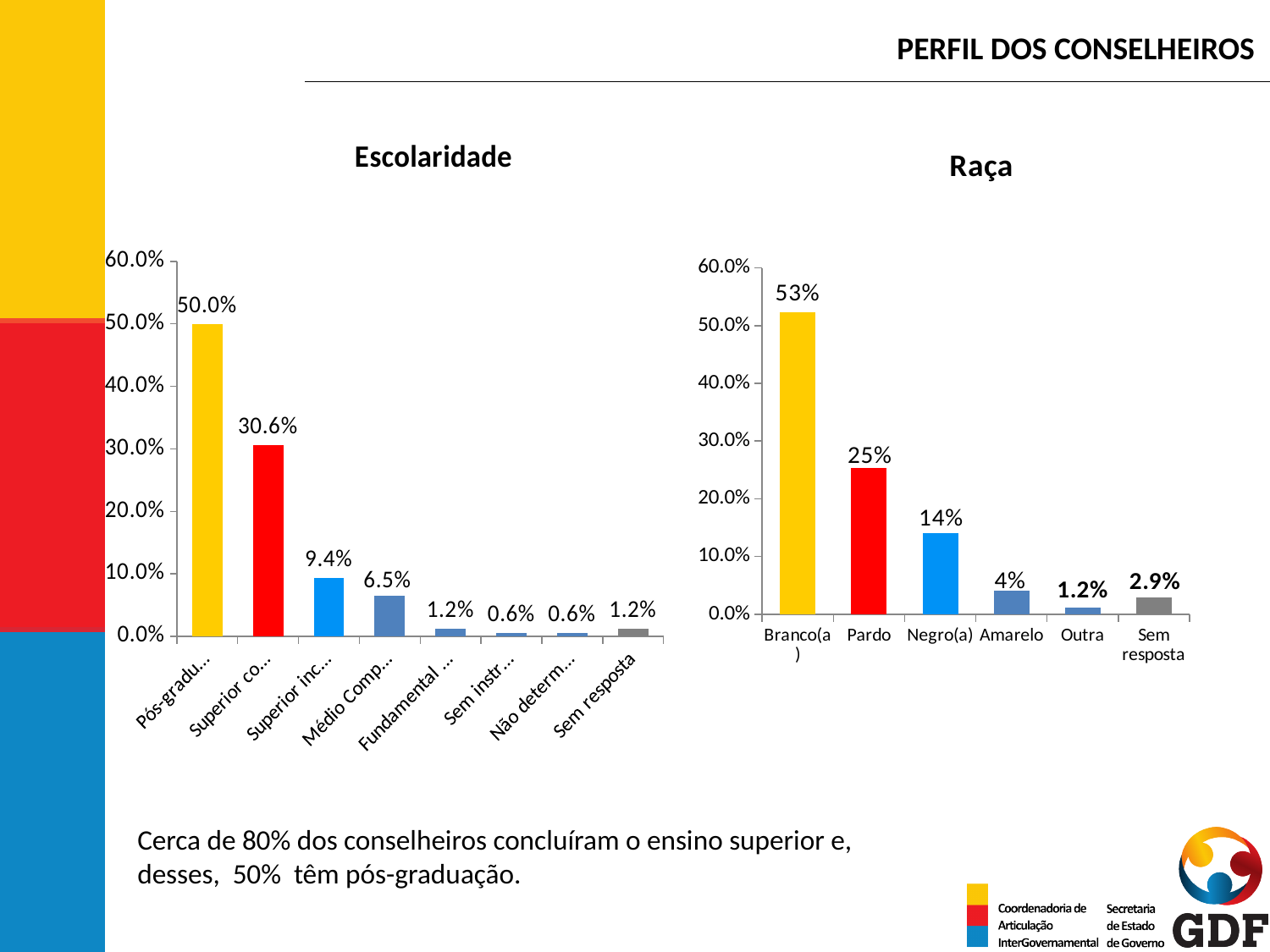
In the Escolaridade chart, how many categories are shown? 8 In the Raça chart, what is the value for Negro(a)? 14% What type of chart is the Raça chart? Bar chart In the Escolaridade chart, what is the value for Sem resposta? 1.2% In the Raça chart, how many categories are shown? 6 In the Escolaridade chart, what is the value of the highest bar? 50.0% In the Raça chart, what is the difference between the values for Branco(a) and Pardo? 28% In the Raça chart, which category has the highest value? Branco(a) In the Raça chart, which category has the lowest value? Outra In the Raça chart, what is the value for Branco(a)? 53% In the Raça chart, what is the value for Pardo? 25% In the Raça chart, what is the value for Sem resposta? 2.9%